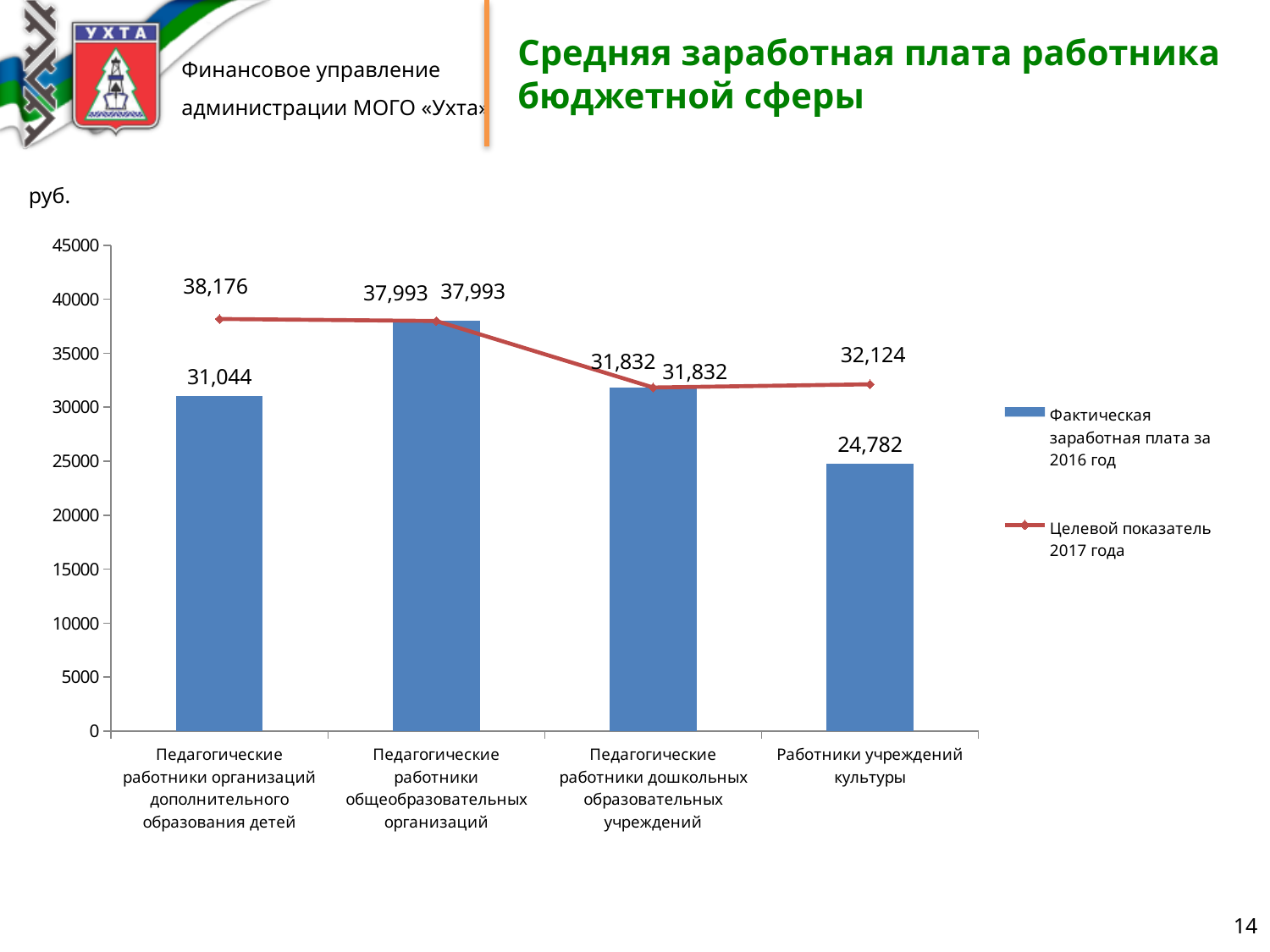
How many series does the chart legend list? 2 What is the difference between the 2017 target and the actual 2016 salary for Педагогические работники организаций дополнительного образования детей? 7,132 What unit is indicated for the values in the chart? руб. How many categories are shown on the x axis of the chart? 4 What is the actual 2016 salary (Фактическая заработная плата за 2016 год) for Работники учреждений культуры? 24,782 What is the difference between the 2017 target and the actual 2016 salary for Работники учреждений культуры? 7,342 Which category has the highest actual 2016 salary? Педагогические работники общеобразовательных организаций What is the 2017 target (Целевой показатель 2017 года) for Педагогические работники организаций дополнительного образования детей? 38,176 What is the 2017 target for Работники учреждений культуры? 32,124 What is the actual 2016 salary for Педагогические работники общеобразовательных организаций? 37,993 Which category has the lowest actual 2016 salary? Работники учреждений культуры Which is larger: the actual 2016 salary for Педагогические работники дошкольных образовательных учреждений or for Педагогические работники организаций дополнительного образования детей? Педагогические работники дошкольных образовательных учреждений